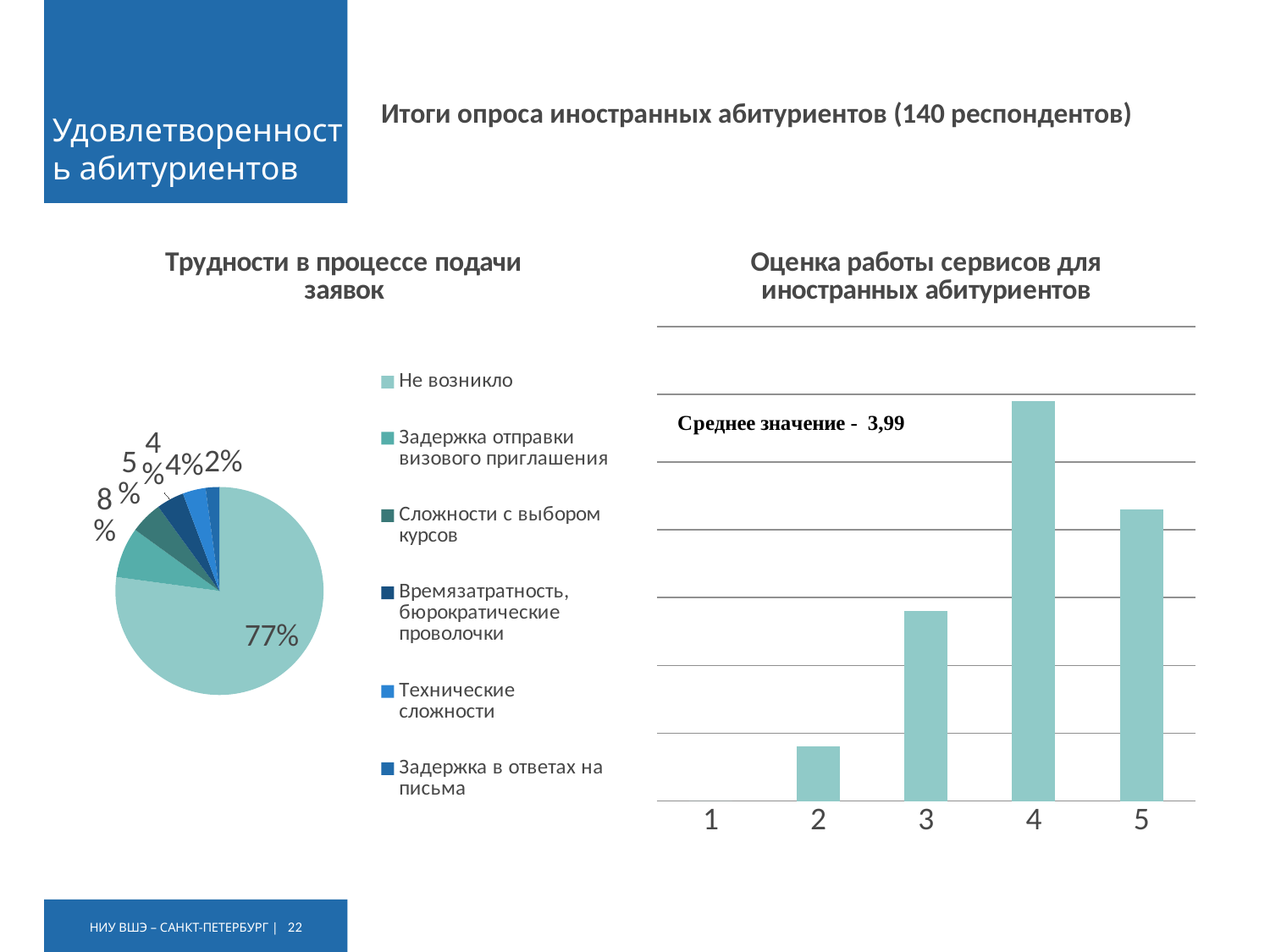
In the pie chart 'Трудности в процессе подачи заявок', what share is shown for 'Задержка отправки визового приглашения'? 8% What type of chart is 'Оценка работы сервисов для иностранных абитуриентов'? bar chart What average value ('Среднее значение') is printed on the bar chart 'Оценка работы сервисов для иностранных абитуриентов'? 3,99 How many rating categories are shown on the x axis of the bar chart 'Оценка работы сервисов для иностранных абитуриентов'? 5 In the bar chart 'Оценка работы сервисов для иностранных абитуриентов', which bar is taller, rating 3 or rating 5? 5 In the pie chart 'Трудности в процессе подачи заявок', what share is labelled for 'Не возникло'? 77% In the pie chart 'Трудности в процессе подачи заявок', which category has the smallest slice? Задержка в ответах на письма In the pie chart 'Трудности в процессе подачи заявок', which category has the largest slice? Не возникло What is the difference between the 'Не возникло' share and the 'Задержка отправки визового приглашения' share in the pie chart? 69% In the pie chart 'Трудности в процессе подачи заявок', what share is shown for 'Задержка в ответах на письма'? 2% How many categories does the legend of the pie chart 'Трудности в процессе подачи заявок' list? 6 In the bar chart 'Оценка работы сервисов для иностранных абитуриентов', which rating has the tallest bar? 4